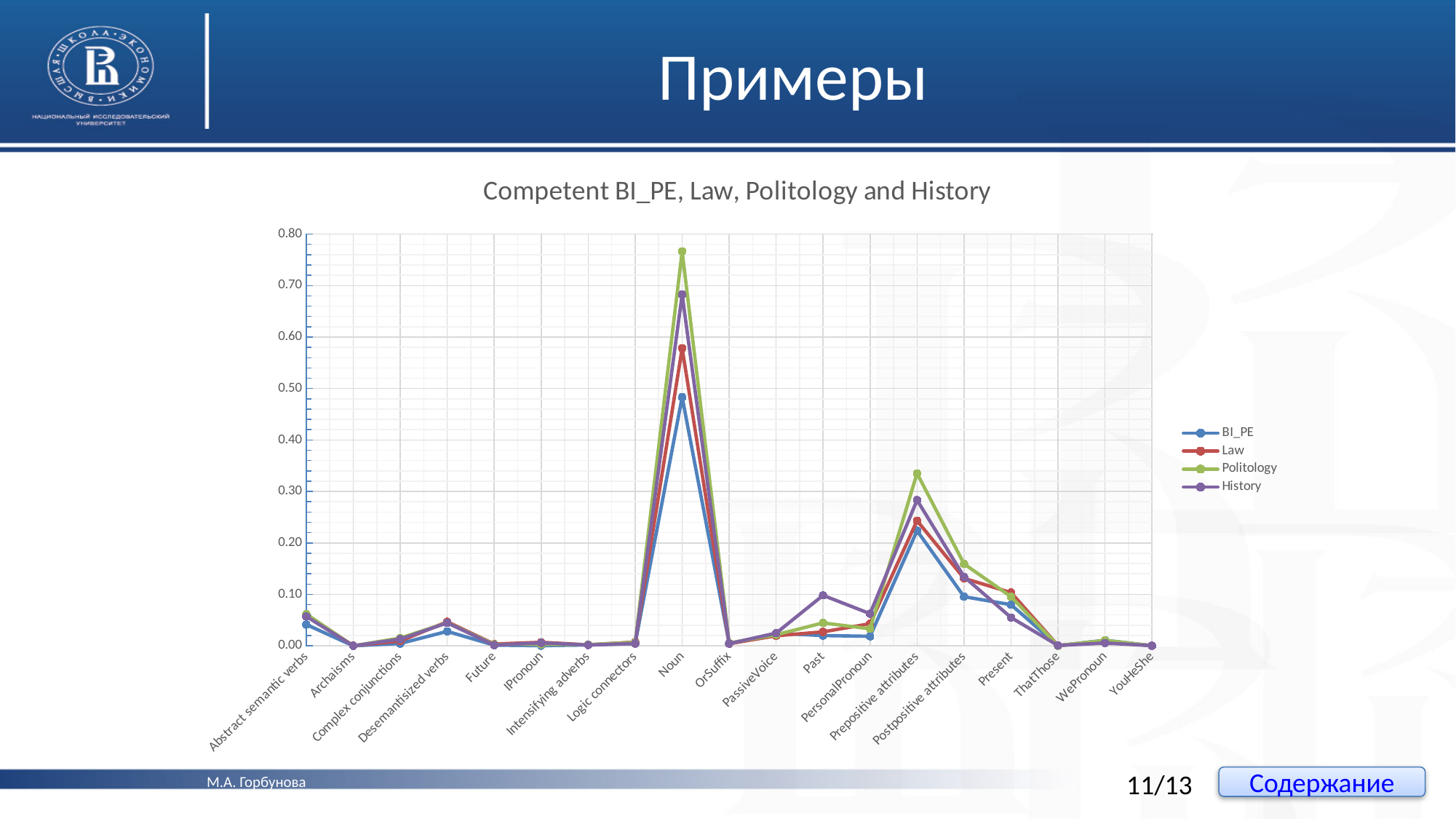
Which series has the highest value at Past? History Is the value for BI_PE at Noun greater or less than 0.40? greater Is the value for Politology at Noun greater or less than 0.70? greater At Noun, which is larger: the value for Politology or the value for BI_PE? Politology What is the title of the chart? Competent BI_PE, Law, Politology and History How many series does the legend list? 4 How many categories are shown along the x axis? 19 What kind of chart is shown on the slide? line chart Is the value for Politology at Prepositive attributes greater or less than 0.30? greater Which series is drawn in green in the legend? Politology Which series has the highest value at Noun? Politology For which category does the Politology series reach its highest value? Noun